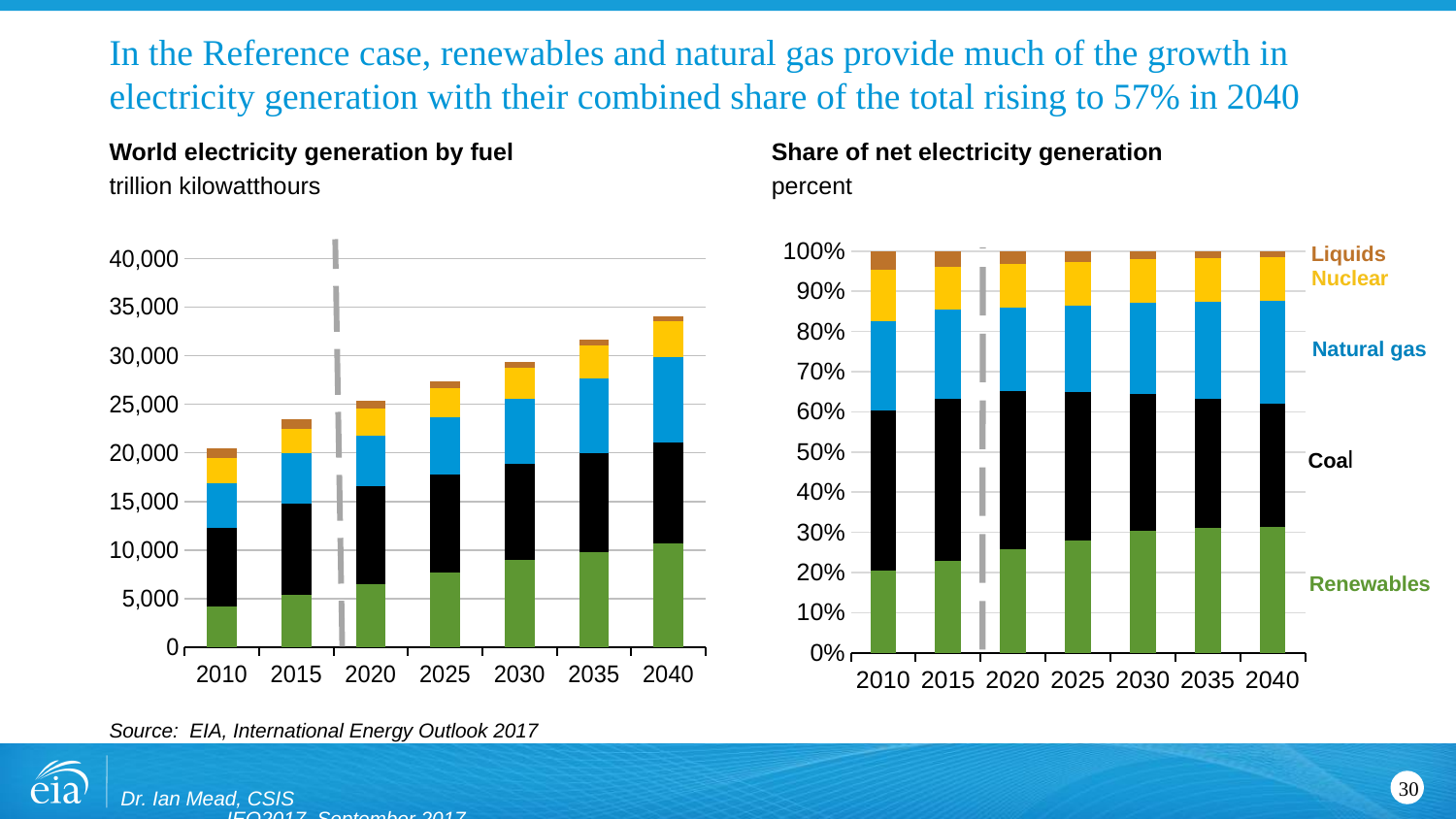
In the 'World electricity generation by fuel' chart, does total generation rise or fall from 2010 to 2040? Rise In the 'World electricity generation by fuel' chart, is the total for 2040 greater or less than 30,000? greater Which fuel is shown in black in the 'Share of net electricity generation' chart? Coal In the 'Share of net electricity generation' chart, does the Renewables share rise or fall from 2010 to 2040? Rise What unit is used on the 'World electricity generation by fuel' chart? trillion kilowatthours What type of chart is the 'World electricity generation by fuel' chart on the left? Stacked bar chart In the 'World electricity generation by fuel' chart, is the total for 2025 greater or less than 25,000? greater In the 'Share of net electricity generation' chart, is the Renewables share in 2040 greater or less than 20%? greater How many years are shown on the x axis of the 'World electricity generation by fuel' chart? 7 How many fuel categories does the legend of the 'Share of net electricity generation' chart list? 5